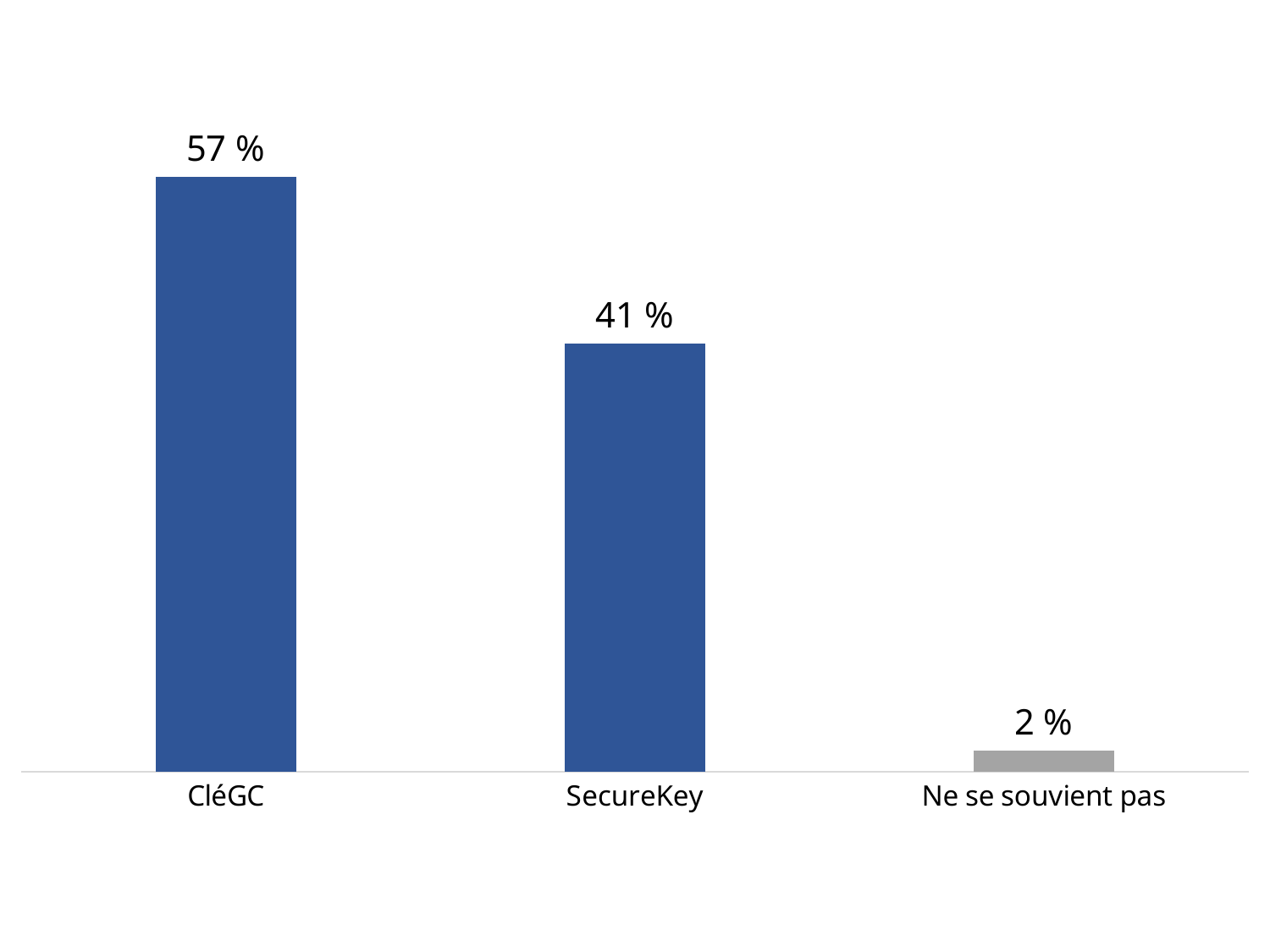
Which is larger, the value for CléGC or the value for SecureKey? CléGC Which category has the lowest value? Ne se souvient pas What is the difference between the values for SecureKey and Ne se souvient pas? 39 % What is the value for CléGC? 57 % What is the value for SecureKey? 41 % What is the difference between the values for CléGC and SecureKey? 16 % What is the value for Ne se souvient pas? 2 % Which category has the highest value? CléGC What kind of chart is shown on the slide? Bar chart Which bar is coloured grey rather than blue? Ne se souvient pas Do the values rise or fall from left to right along the x axis? Fall How many categories are shown in the chart? 3